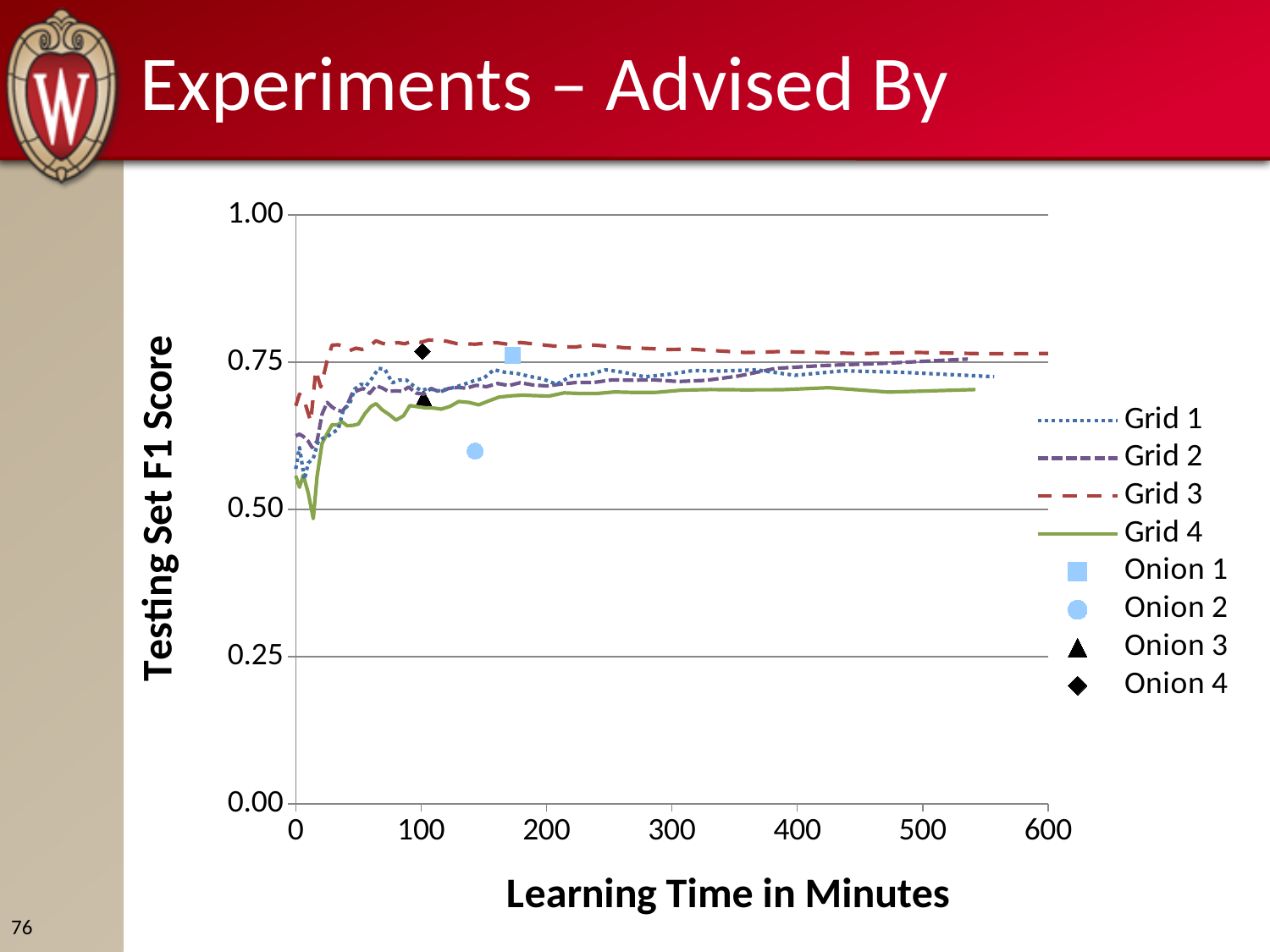
Is the value for Onion 2 greater or less than 0.50? greater How many series does the legend list? 8 Is the value for Onion 3 greater or less than 0.75? less Is the Testing Set F1 Score for Grid 4 at 500 minutes greater or less than 0.75? less Does the Grid 4 line overall rise or fall as learning time increases? rise Which Grid series has the lowest Testing Set F1 Score across most of the learning time range? Grid 4 What is the title of the chart's y axis? Testing Set F1 Score Which has the higher Testing Set F1 Score, Onion 4 or Onion 2? Onion 4 What is the title of the chart's x axis? Learning Time in Minutes What kind of chart is shown on the slide? Line chart with scatter points Which Grid series has the highest Testing Set F1 Score across most of the learning time range? Grid 3